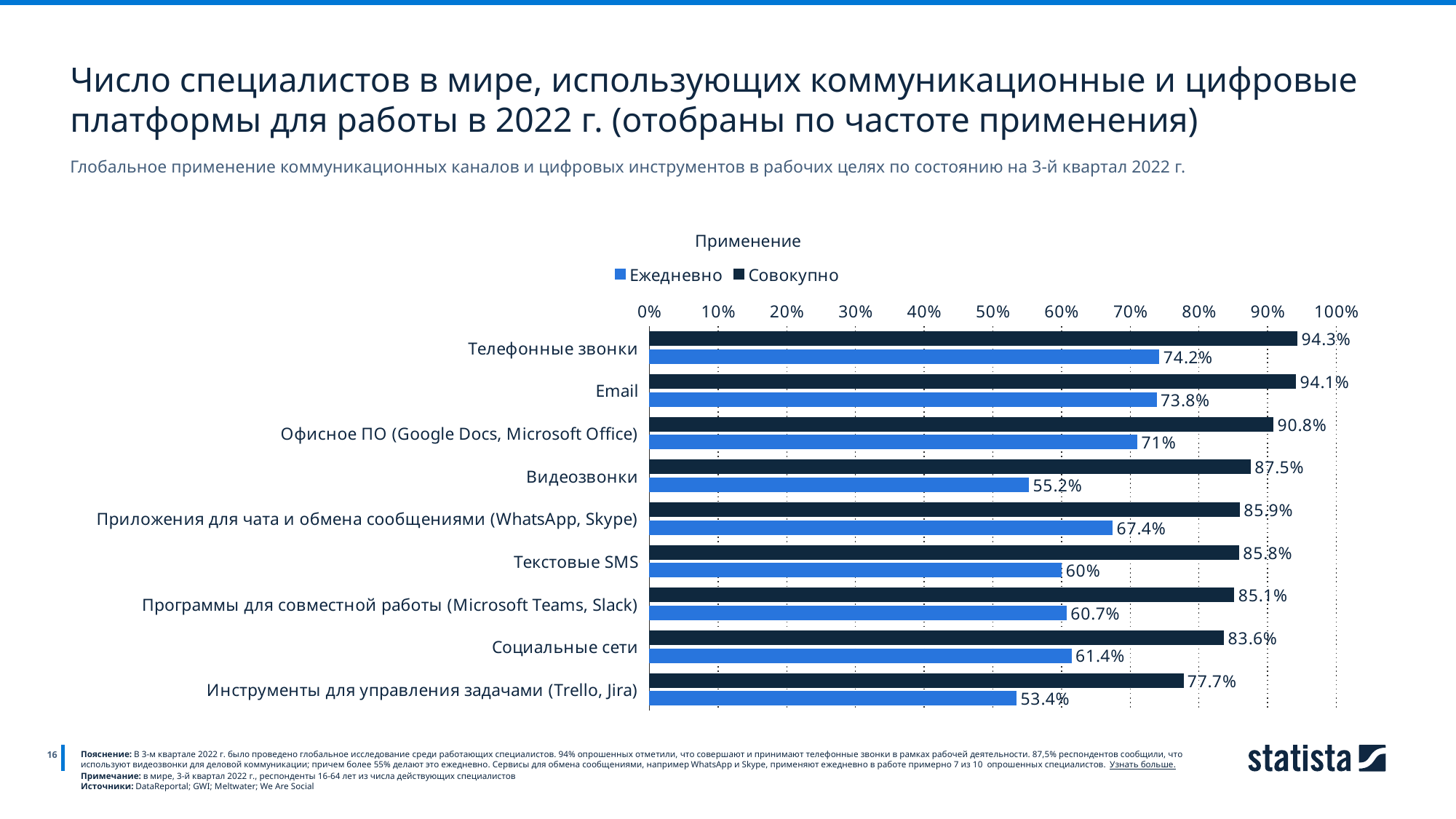
Which category has the highest Совокупно value? Телефонные звонки Which category has the lowest Совокупно value? Инструменты для управления задачами (Trello, Jira) How many series does the legend list? 2 What is the difference between the Совокупно and Ежедневно values for Видеозвонки? 32.3 percentage points What is the Ежедневно value for Видеозвонки? 55.2% What is the title shown above the legend of the chart? Применение What is the Совокупно value for Инструменты для управления задачами (Trello, Jira)? 77.7% What kind of chart is shown on the slide? Bar chart Which has the larger Ежедневно value: Социальные сети or Текстовые SMS? Социальные сети What is the Совокупно value for Телефонные звонки? 94.3% What is the Ежедневно value for Офисное ПО (Google Docs, Microsoft Office)? 71% How many categories are shown in the chart? 9